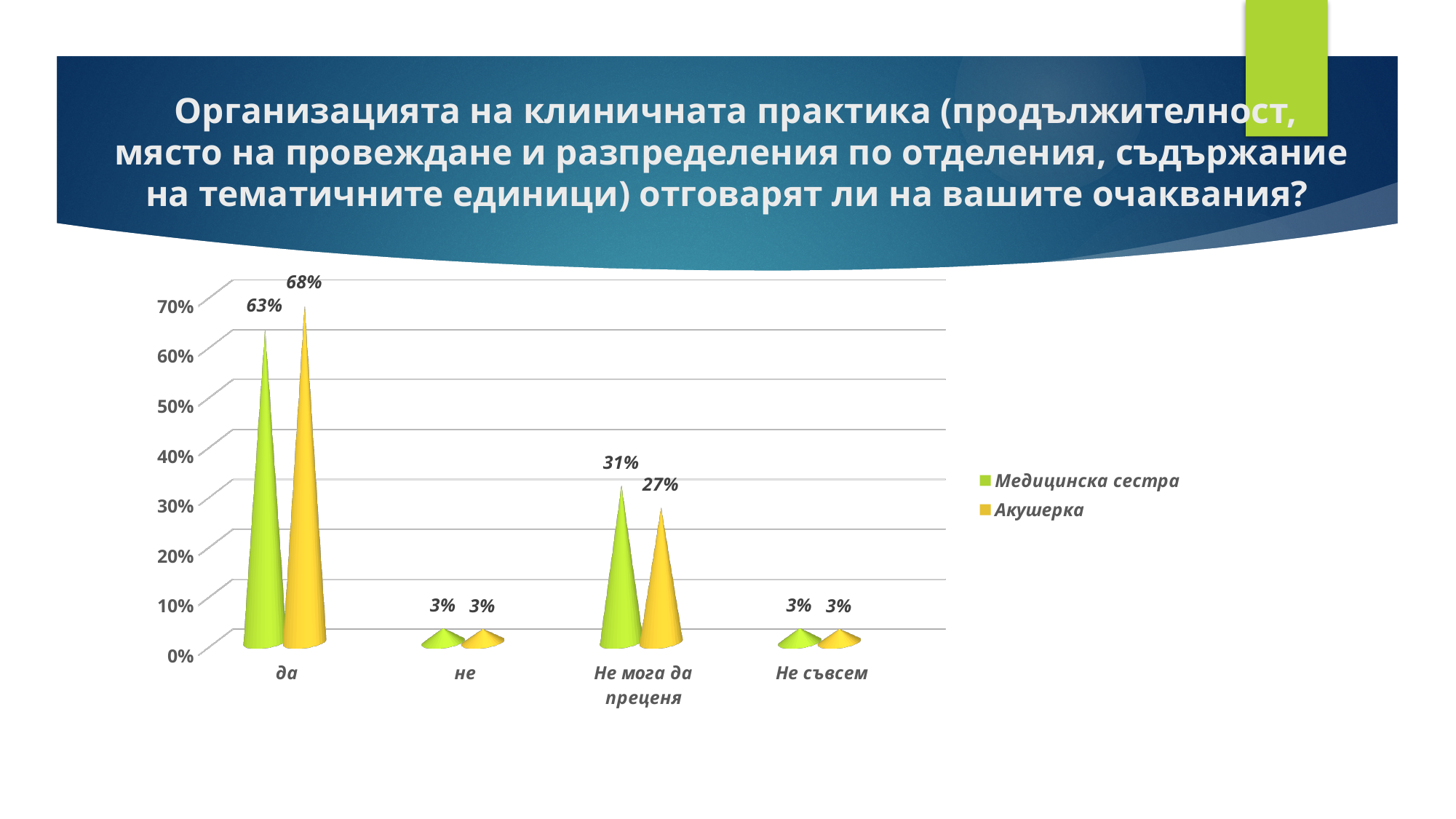
What is the value for "Медицинска сестра" in the "да" category? 63% What is the value for "Акушерка" in the "Не съвсем" category? 3% What is the value for "Акушерка" in the "да" category? 68% What kind of chart is shown on the slide? bar chart Which category has the highest value for "Акушерка"? да In the "Не мога да преценя" category, which series has the larger value? Медицинска сестра What is the difference between the "Акушерка" and "Медицинска сестра" values in the "да" category? 5% Which colour represents the "Акушерка" series? yellow How many categories are shown on the x axis? 4 How many series does the legend list? 2 What is the difference between the "Медицинска сестра" and "Акушерка" values in the "Не мога да преценя" category? 4% What is the value for "Медицинска сестра" in the "Не мога да преценя" category? 31%